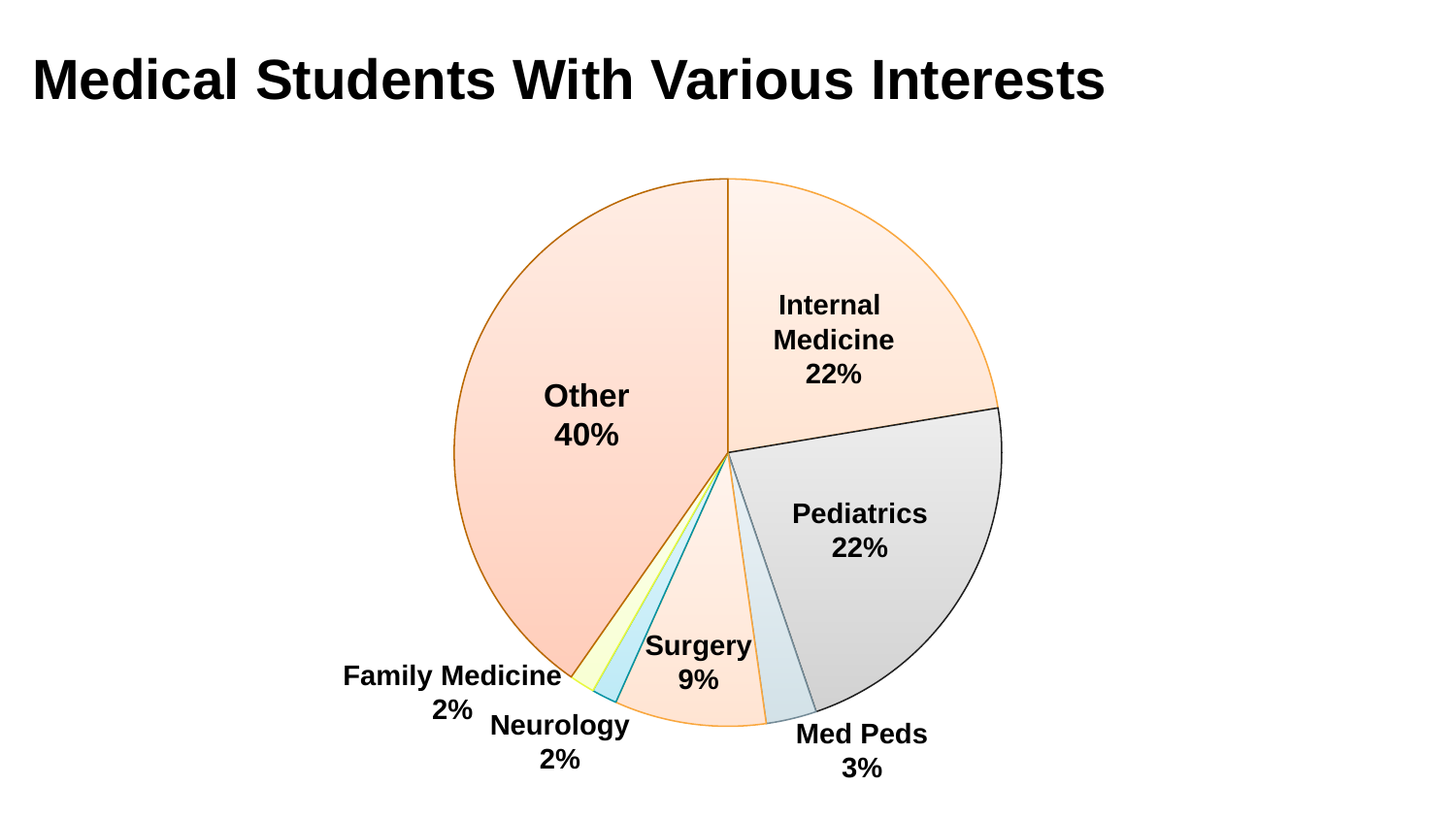
What is the value shown for Med Peds? 3% What is the title of the chart? Medical Students With Various Interests Which category has the largest slice of the pie? Other What is the difference between the Internal Medicine slice and the Med Peds slice? 19% What is the value shown for Surgery? 9% What share of the pie does Pediatrics represent? 22% What is the difference between the Other slice and the Surgery slice? 31% How many labeled slices does the pie chart have? 7 What percentage is shown for Neurology? 2% Which is larger, the slice for Other or the slice for Internal Medicine? Other What percentage of the pie is labeled Other? 40% What kind of chart is shown on the slide? pie chart